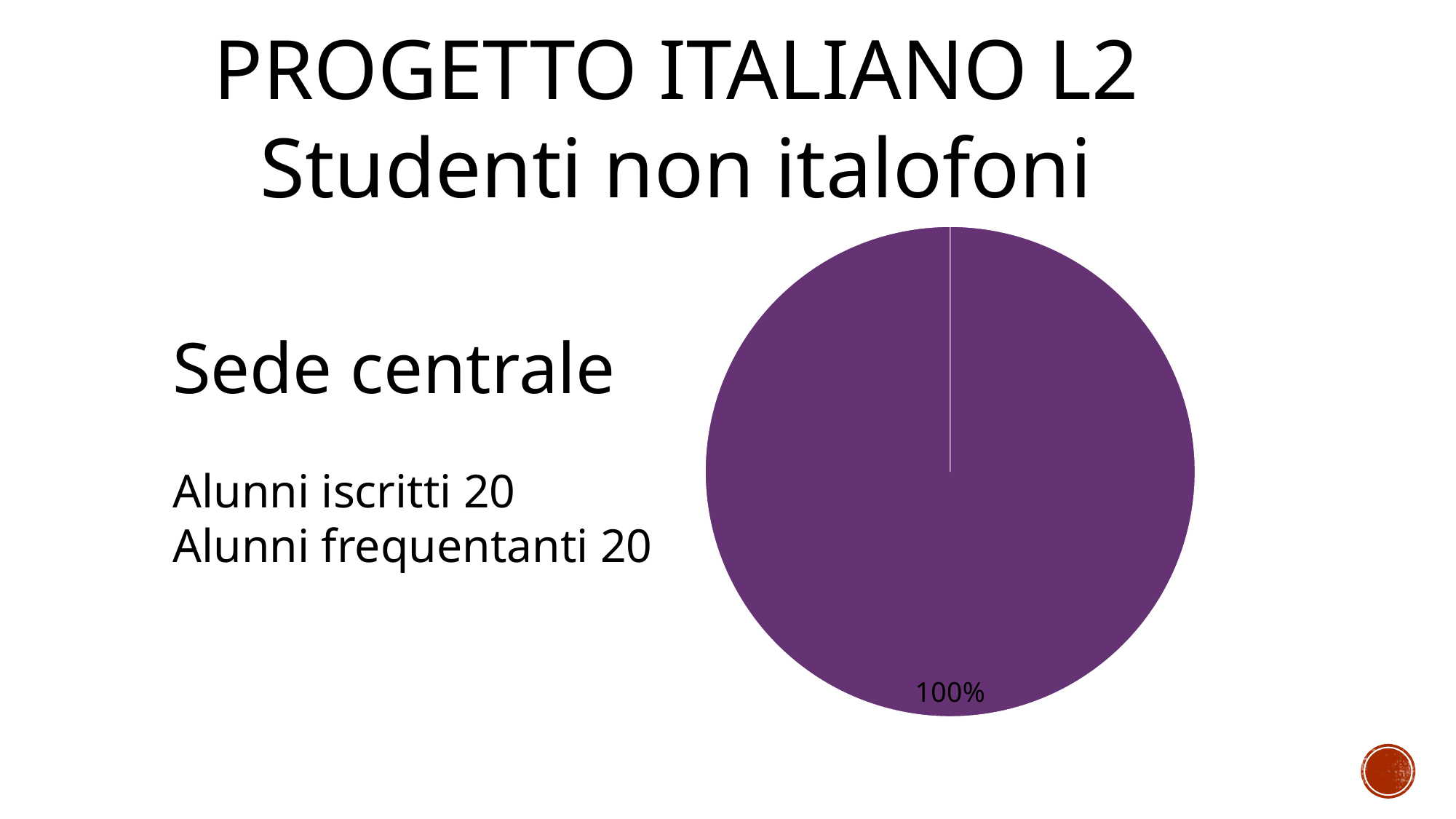
How many slices does the pie chart have? 1 What kind of chart is shown on the slide? pie chart Does the pie chart show a legend? No What share of the pie does the single slice take up? 100% What colour is the pie chart's slice? purple What percentage is printed on the pie chart's slice? 100%